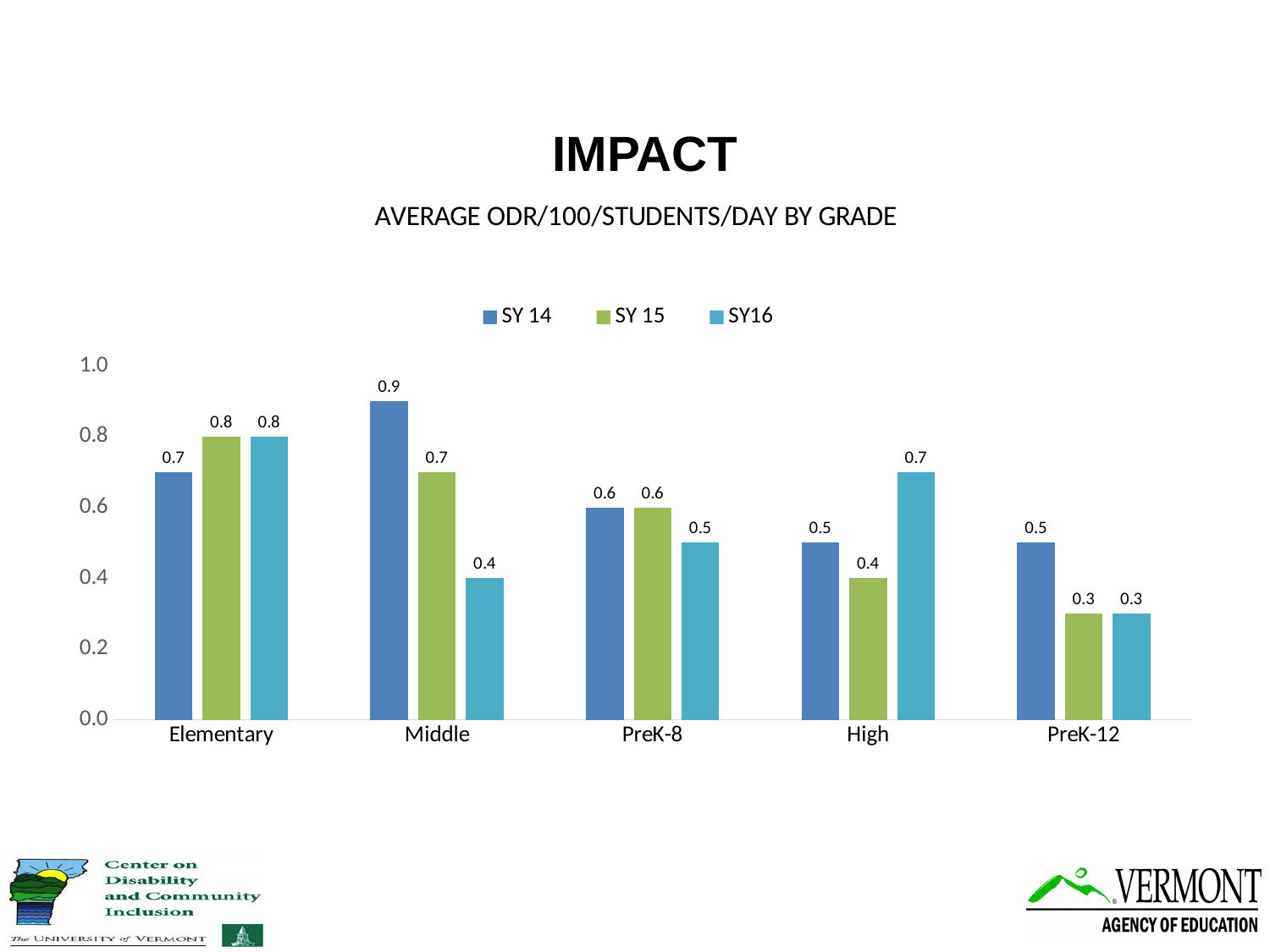
What is the difference between the SY 14 and SY16 values for Middle? 0.5 Which grade category has the lowest SY16 value? PreK-12 What is the subtitle of the chart? AVERAGE ODR/100/STUDENTS/DAY BY GRADE What is the SY16 value for High? 0.7 Which grade category has the highest SY 14 value? Middle Which is larger for High: the SY 15 value or the SY16 value? SY16 What is the SY 15 value for PreK-12? 0.3 What kind of chart is shown on the slide? Bar chart What is the SY 14 value for Middle? 0.9 How many series does the legend list? 3 Do the SY16 values rise or fall from Elementary to Middle? Fall How many grade categories are shown on the x axis? 5